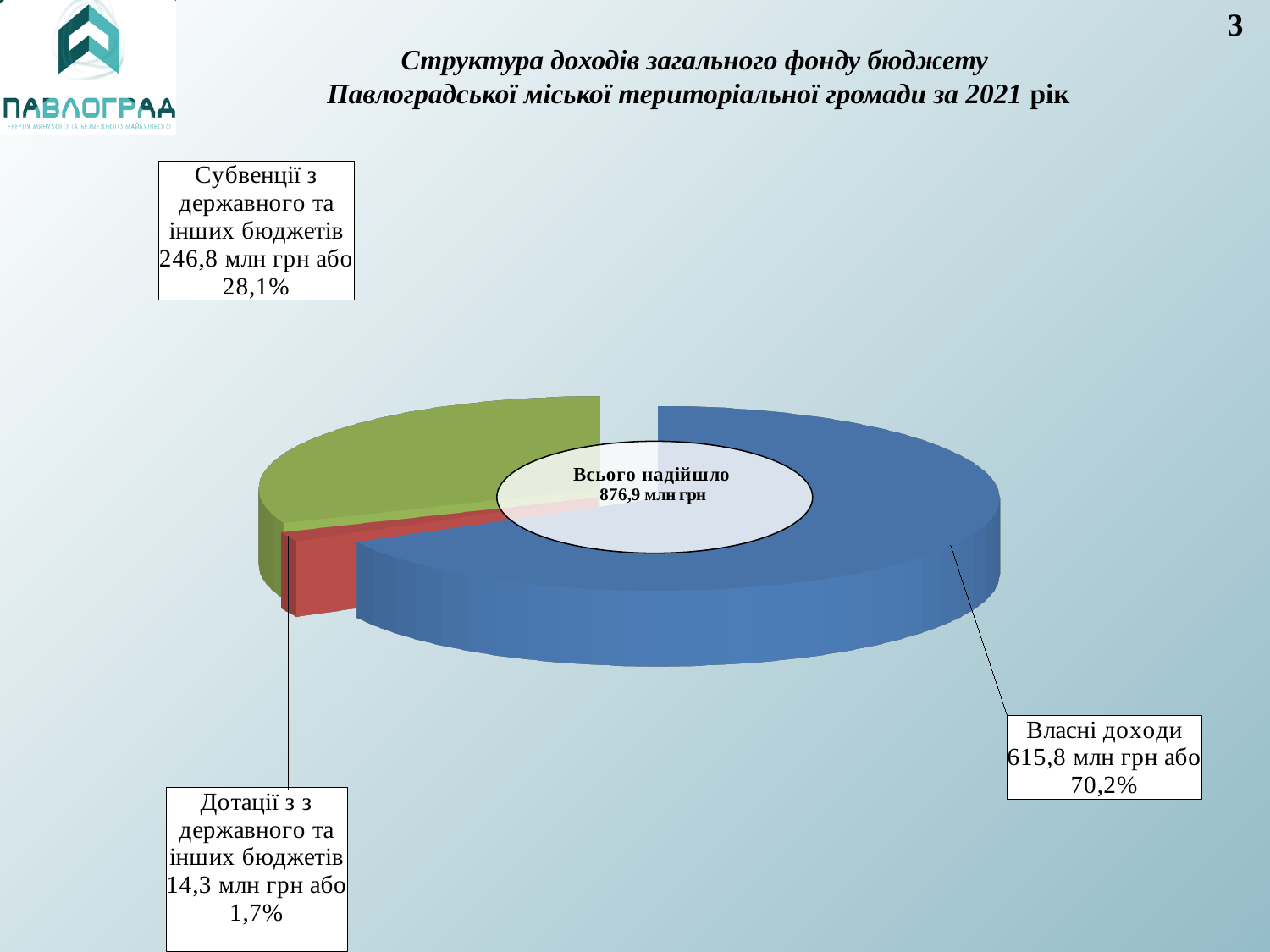
What is the difference between Власні доходи and Субвенції з державного та інших бюджетів in млн грн? 369,0 млн грн What is the value for Власні доходи? 615,8 млн грн What kind of chart is shown on the slide? pie chart How many slices does the pie chart have? 3 What is the value for Дотації з державного та інших бюджетів? 14,3 млн грн Which category has the largest slice of the pie? Власні доходи What is the value for Субвенції з державного та інших бюджетів? 246,8 млн грн What total amount is shown in the centre of the pie chart (Всього надійшло)? 876,9 млн грн Which category has the smallest slice of the pie? Дотації з державного та інших бюджетів Which is larger, Субвенції з державного та інших бюджетів or Дотації з державного та інших бюджетів? Субвенції з державного та інших бюджетів What share of the pie is Субвенції з державного та інших бюджетів? 28,1% What share of the pie is Власні доходи? 70,2%